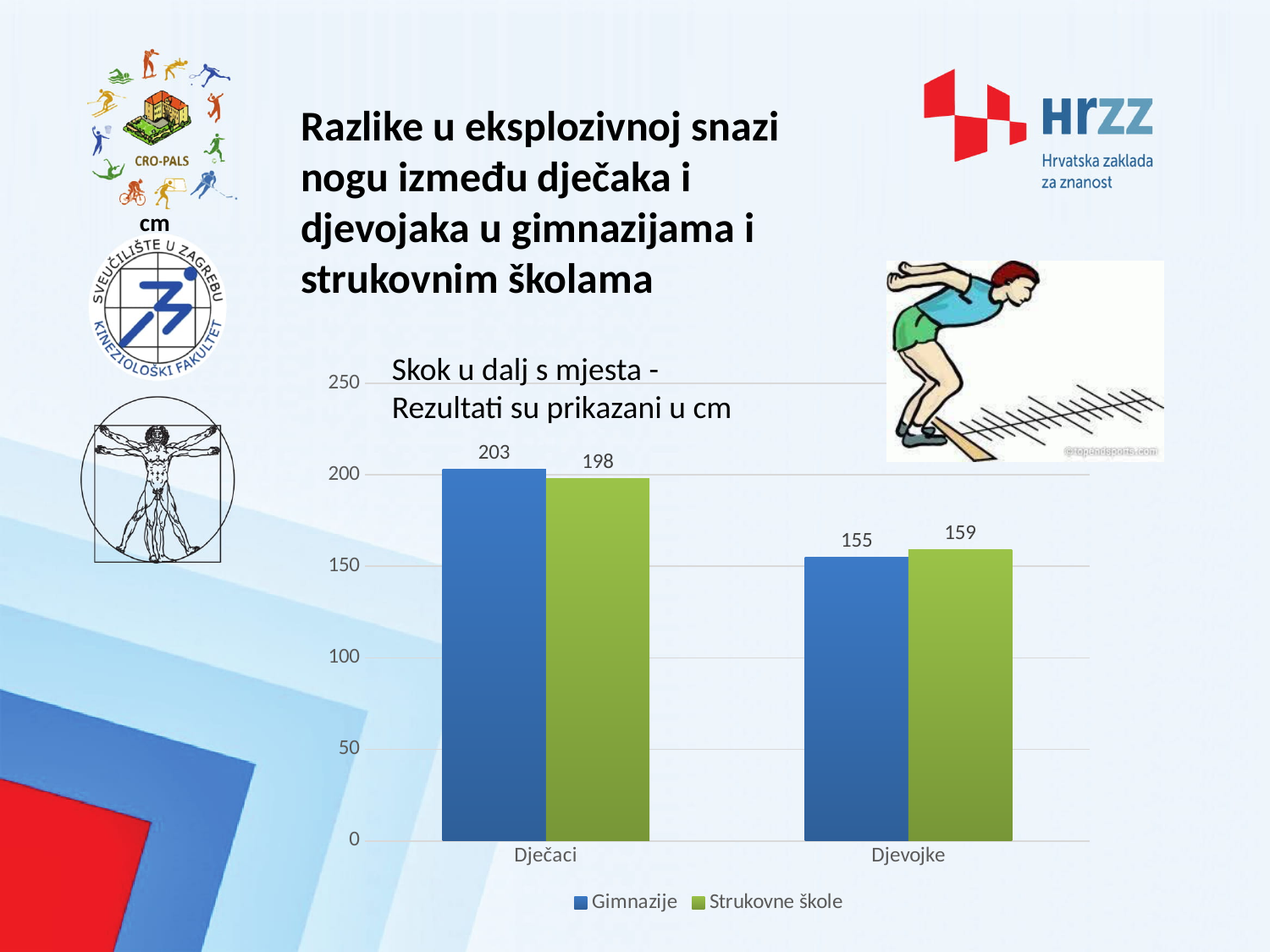
What is the value for Strukovne škole in the Dječaci category? 198 Which bar has the highest value in the chart? Gimnazije, Dječaci What is the value for Gimnazije in the Djevojke category? 155 What is the difference between the Strukovne škole and Gimnazije values for Djevojke? 4 How many series does the legend list? 2 What is the value for Strukovne škole in the Djevojke category? 159 Which bar has the lowest value in the chart? Gimnazije, Djevojke What kind of chart is shown on the slide? Bar chart What is the value for Gimnazije in the Dječaci category? 203 For Djevojke, which series has the larger value, Gimnazije or Strukovne škole? Strukovne škole How many categories are shown on the x axis? 2 What is the difference between the Gimnazije and Strukovne škole values for Dječaci? 5